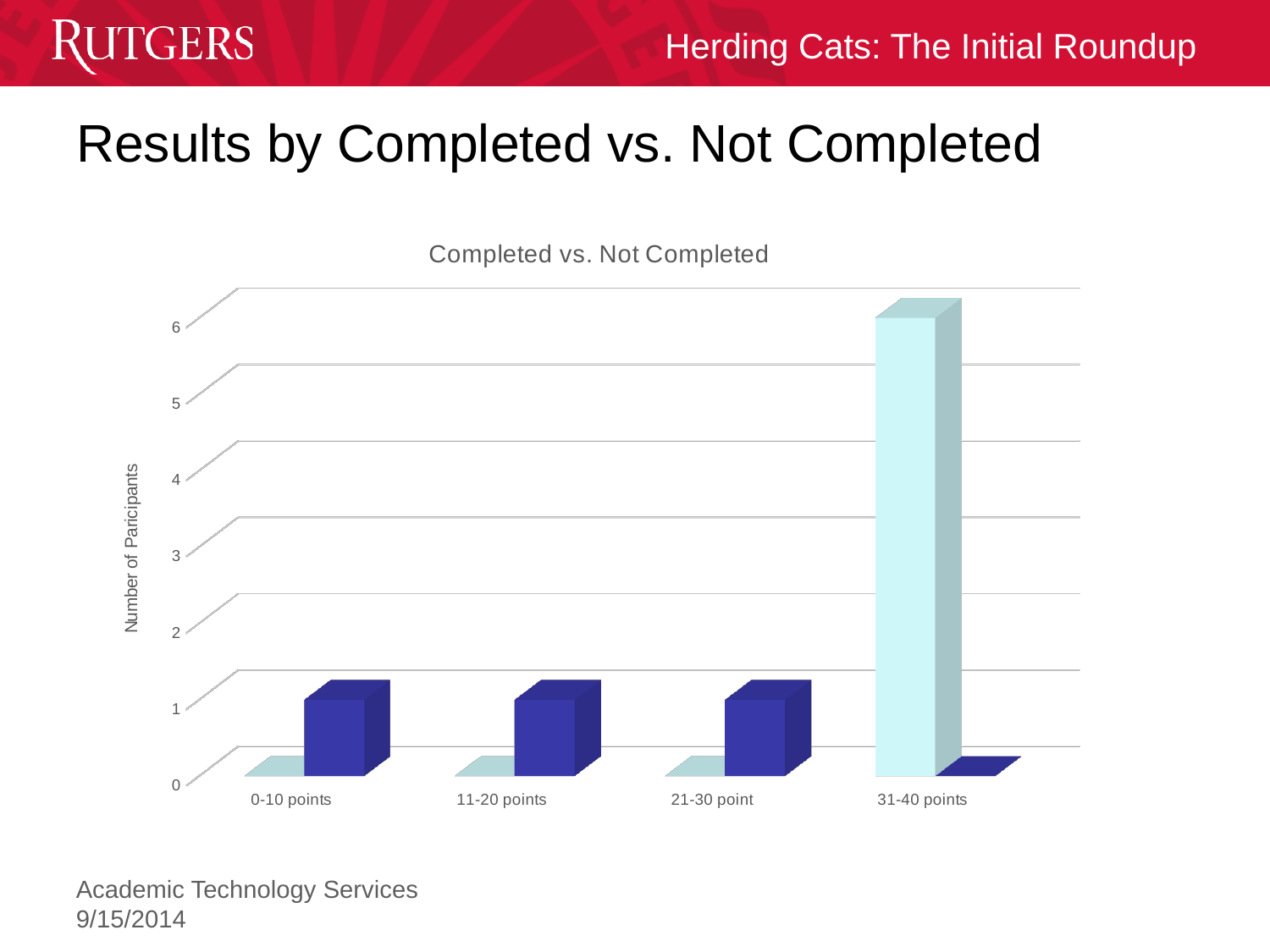
What is the title of the chart? Completed vs. Not Completed What is the difference between the light blue bar for 31-40 points and the dark blue bar for 0-10 points? 5 Is the value of the light blue bar for 31-40 points greater or less than 5? greater What is the label on the vertical axis of the chart? Number of Paricipants Is the value of the dark blue bar for 11-20 points greater or less than 2? less Which is larger: the light blue bar for 31-40 points or the dark blue bar for 21-30 point? the light blue bar for 31-40 points What type of chart is shown on the slide? bar chart What is the value of the dark blue bar for 0-10 points? 1 Which category has the tallest bar? 31-40 points How many categories are shown on the horizontal axis? 4 What is the value of the light blue bar for 31-40 points? 6 What is the highest value shown on the vertical axis? 6